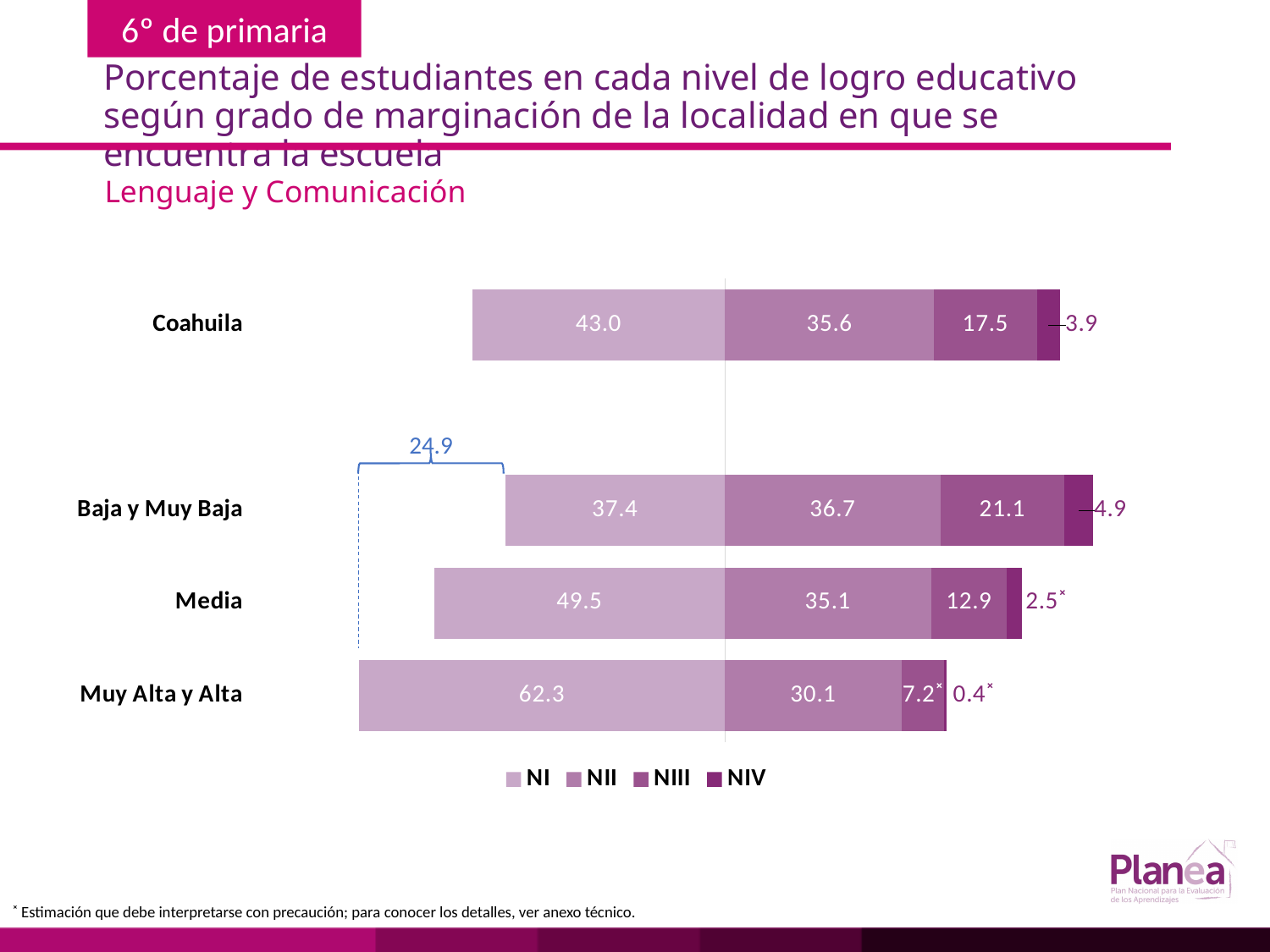
Which category has the lowest NIII value? Muy Alta y Alta What is the NIV value for Baja y Muy Baja? 4.9 What is the NII value for Media? 35.1 What is the NIII value for Muy Alta y Alta? 7.2 What is the NI value for Coahuila? 43.0 What is the total of the stacked bar for Coahuila? 100.0 Which category has the highest NI value? Muy Alta y Alta What kind of chart is shown on the slide? Stacked bar chart Which has the larger NII value, Coahuila or Baja y Muy Baja? Baja y Muy Baja What is the difference between the NI value for Muy Alta y Alta and the NI value for Baja y Muy Baja? 24.9 How many series does the legend list? 4 How many categories are shown in the chart? 4